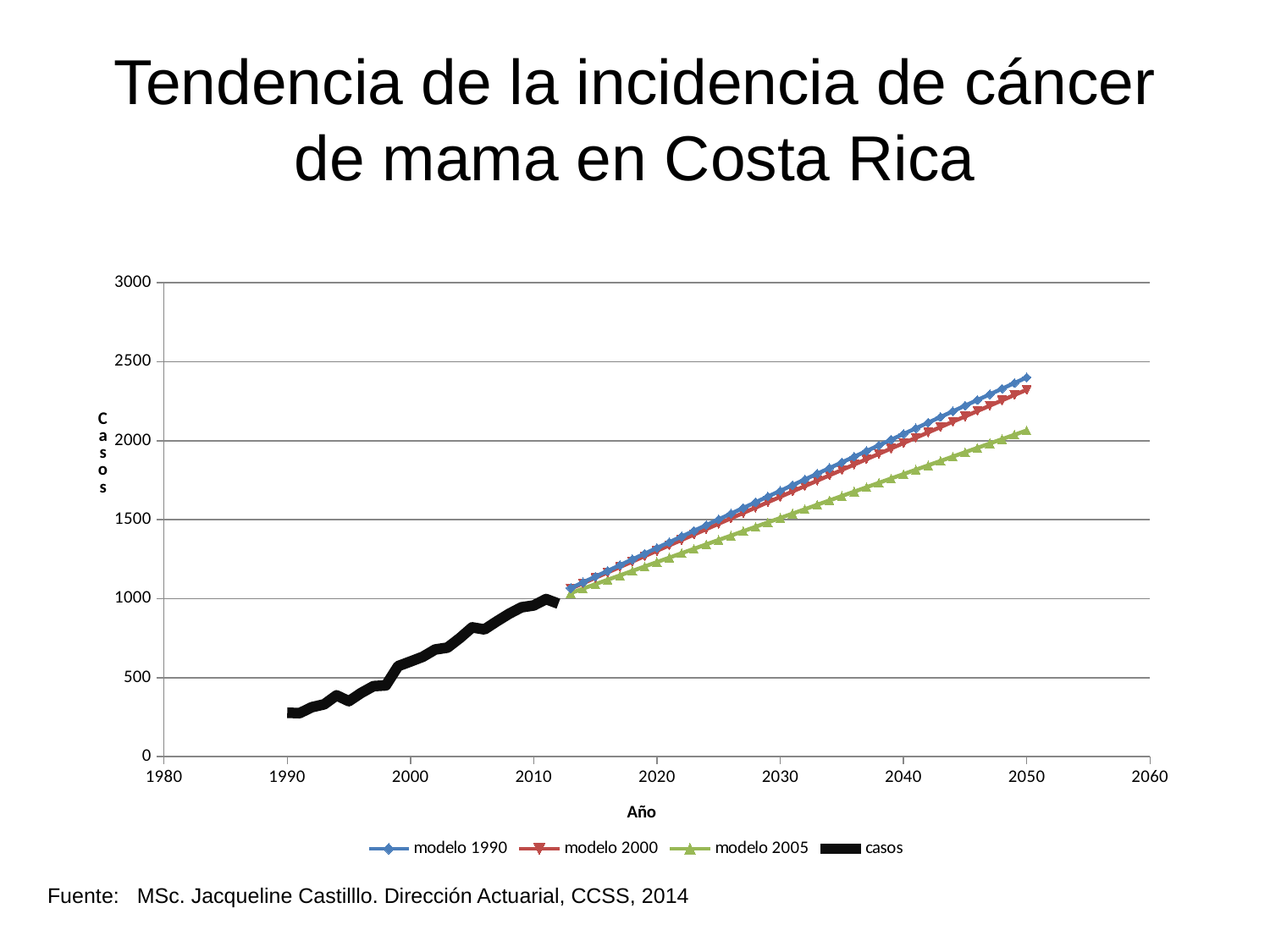
Is the value for 'modelo 2005' in 2050 greater or less than 2500? less Do the values of the 'casos' series rise or fall from 1990 to 2010? rise Do the values of the 'modelo 2005' series rise or fall from 2013 to 2050? rise In 2050, which series has the larger value, 'modelo 1990' or 'modelo 2005'? modelo 1990 Is the value for 'casos' in 1990 greater or less than 500? less What kind of chart is shown on the slide? line chart What is the title of the chart? Tendencia de la incidencia de cáncer de mama en Costa Rica Is the value for 'modelo 1990' in 2030 greater or less than 1500? greater How many series does the legend list? 4 What is the label of the x axis? Año Which of the three model series has the lowest value in 2050? modelo 2005